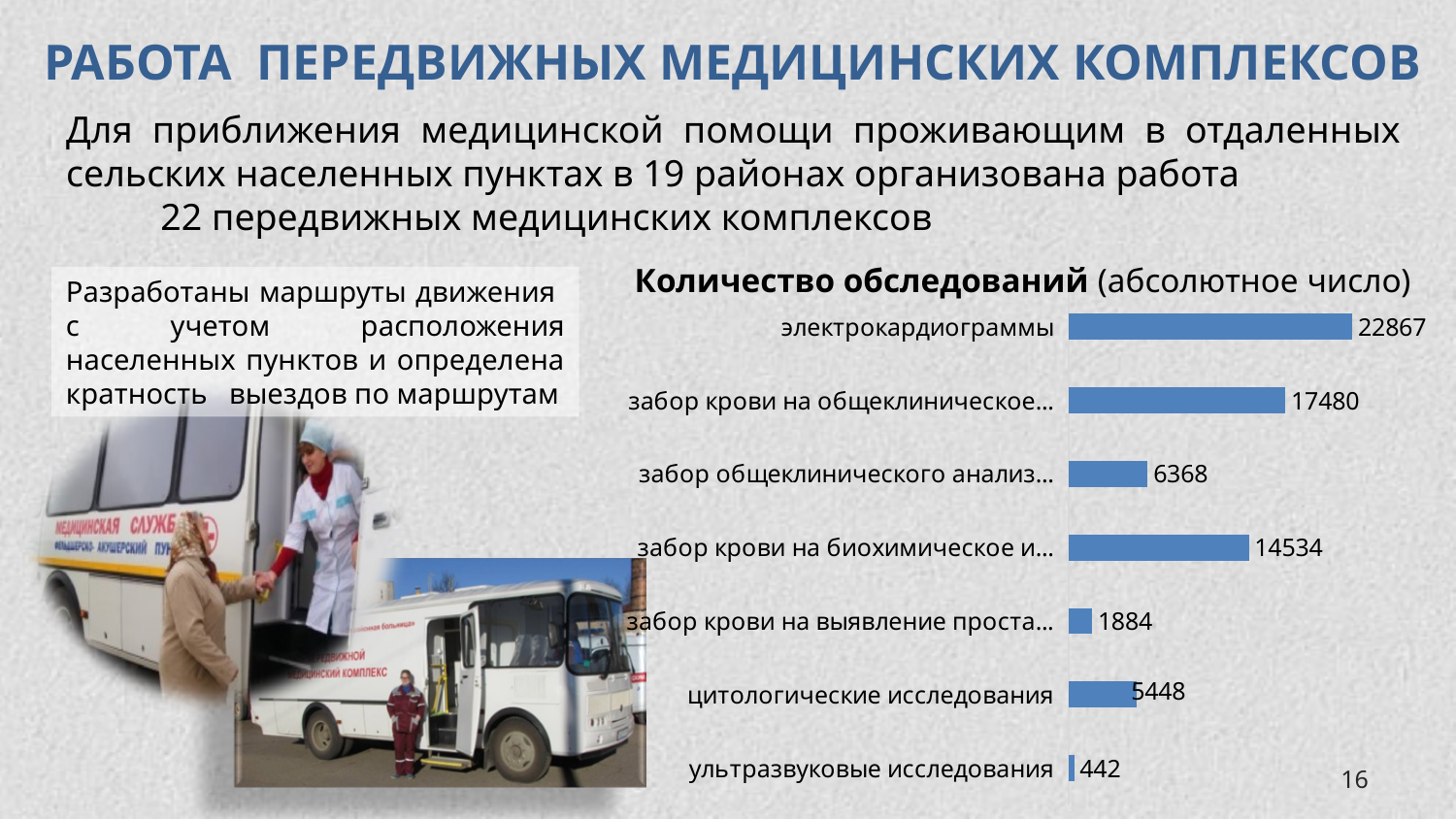
What is the title of the chart? Количество обследований (абсолютное число) Which category has the highest value? электрокардиограммы What is the value for цитологические исследования? 5448 What is the difference between the values for цитологические исследования and ультразвуковые исследования? 5006 What kind of chart is shown on the slide? bar chart How many categories are shown in the chart? 7 What is the value for ультразвуковые исследования? 442 What is the value for the category labelled 'забор крови на биохимическое и…'? 14534 Which category has the lowest value? ультразвуковые исследования Which is larger: the value for 'забор общеклинического анализ…' or the value for цитологические исследования? забор общеклинического анализ… What is the value for электрокардиограммы? 22867 What is the difference between the values for электрокардиограммы and 'забор крови на общеклиническое…'? 5387